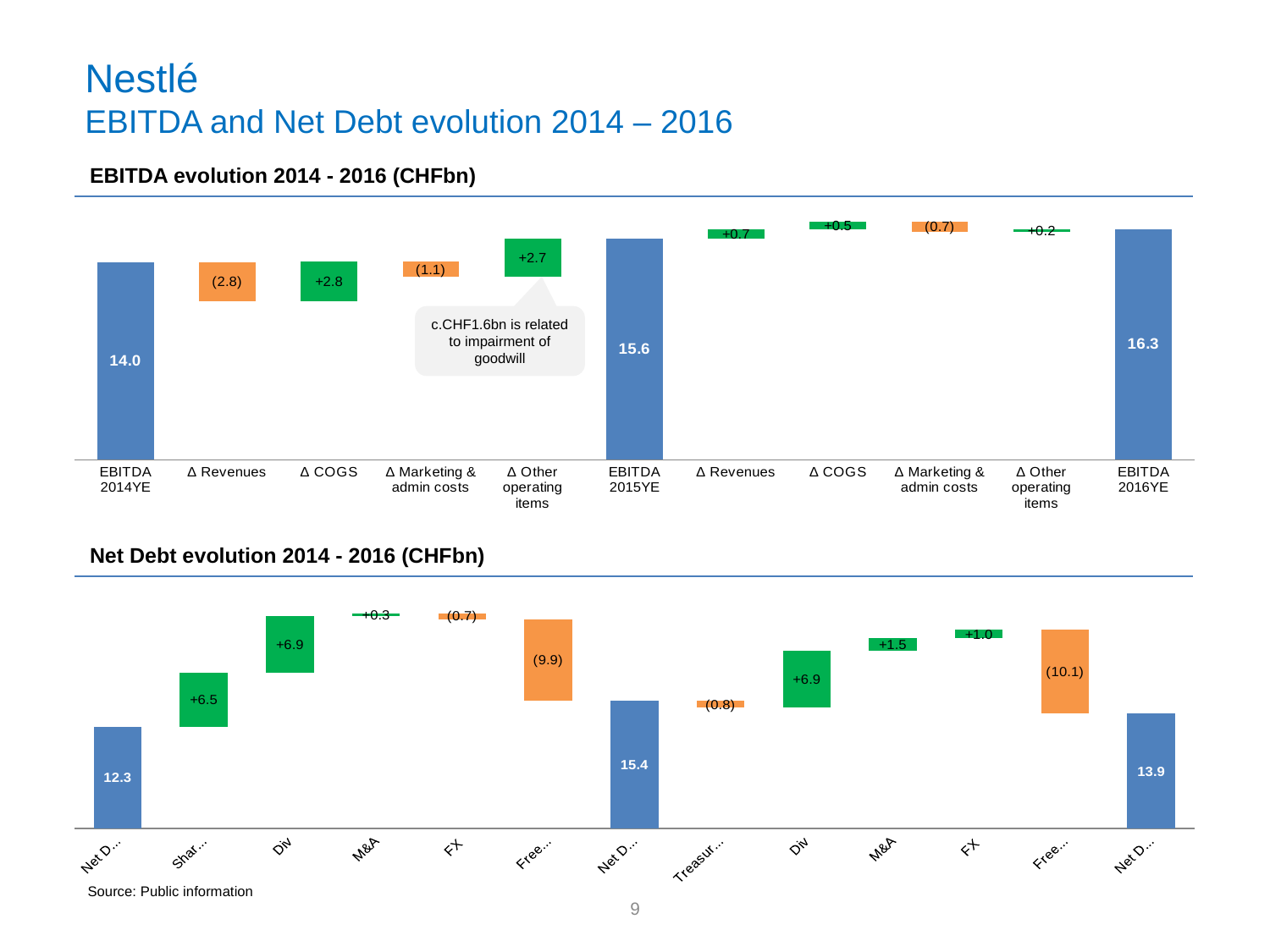
In the EBITDA evolution chart, how many bars are plotted? 11 In the EBITDA evolution chart, what is the Δ COGS value between EBITDA 2014YE and EBITDA 2015YE? +2.8 In the Net Debt evolution chart, what is the value of the first (leftmost) blue bar? 12.3 What kind of chart is the EBITDA evolution chart? Bar chart (waterfall) In the EBITDA evolution chart, what is the Δ Marketing & admin costs value between EBITDA 2015YE and EBITDA 2016YE? (0.7) In the EBITDA evolution chart, by how much is EBITDA 2016YE higher than EBITDA 2014YE? 2.3 In the EBITDA evolution chart, which bar does the callout 'c.CHF1.6bn is related to impairment of goodwill' point to? Δ Other operating items (+2.7, between EBITDA 2014YE and 2015YE) In the Net Debt evolution chart, what is the value of the FX step in the second period (after the 15.4 bar)? +1.0 In the Net Debt evolution chart, what is the difference between the middle blue bar (15.4) and the first blue bar (12.3)? 3.1 In the EBITDA evolution chart, which is larger, EBITDA 2015YE or EBITDA 2016YE? EBITDA 2016YE In the EBITDA evolution chart, what is the value of EBITDA 2016YE? 16.3 In the EBITDA evolution chart, what is the value of EBITDA 2014YE? 14.0